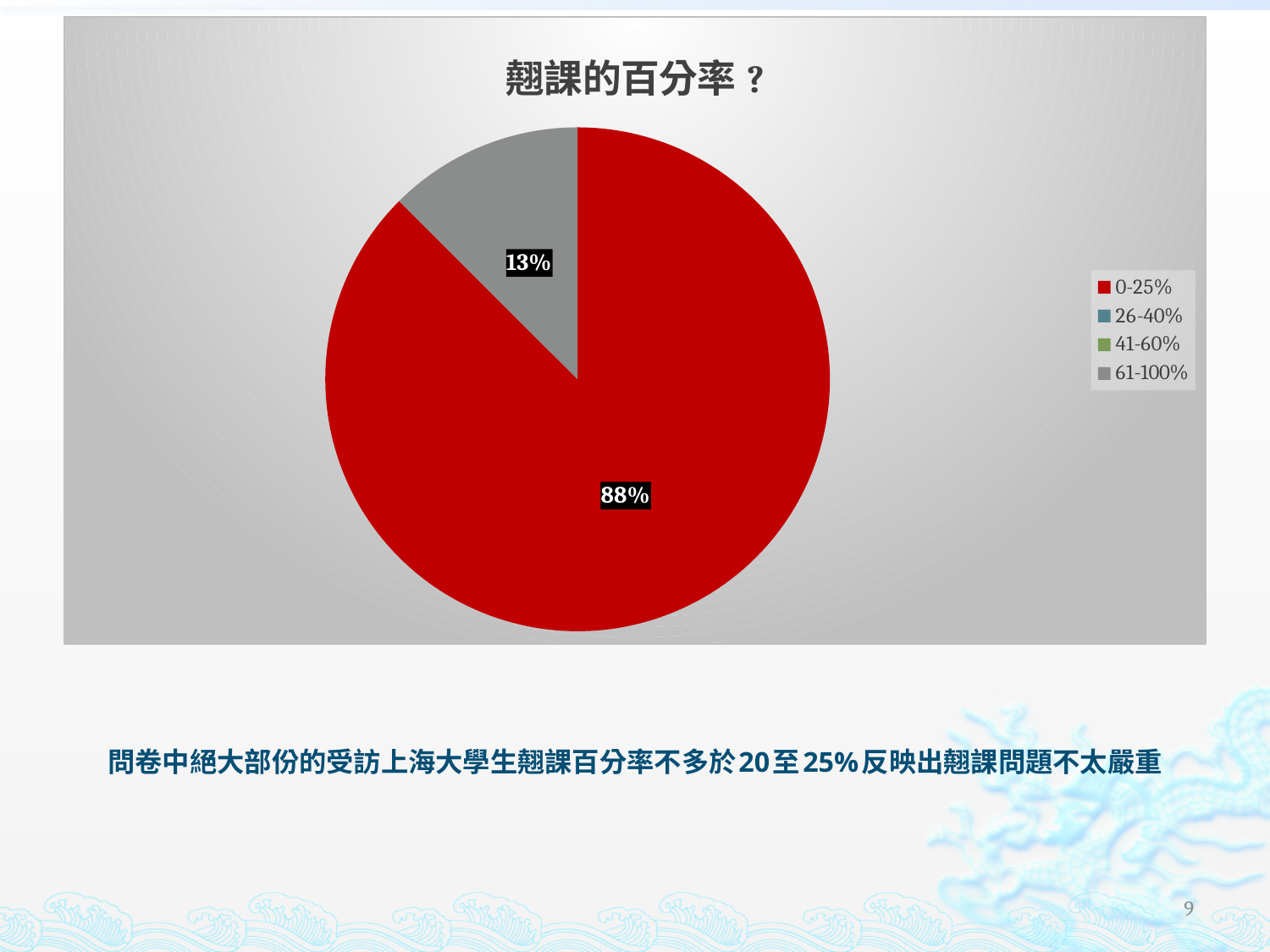
What is the difference between the 0-25% slice and the 61-100% slice? 75% What share of the pie does the 61-100% category take? 13% What kind of chart is shown on the slide? pie chart What is the title of the chart? 翹課的百分率？ What share of the pie does the 0-25% category take? 88% Which category has the largest slice of the pie? 0-25% Which of the two labelled slices is larger, 0-25% or 61-100%? 0-25% How many entries does the chart's legend list? 4 What colour is the slice for the 0-25% category? red How many slices of the pie have a visible data label? 2